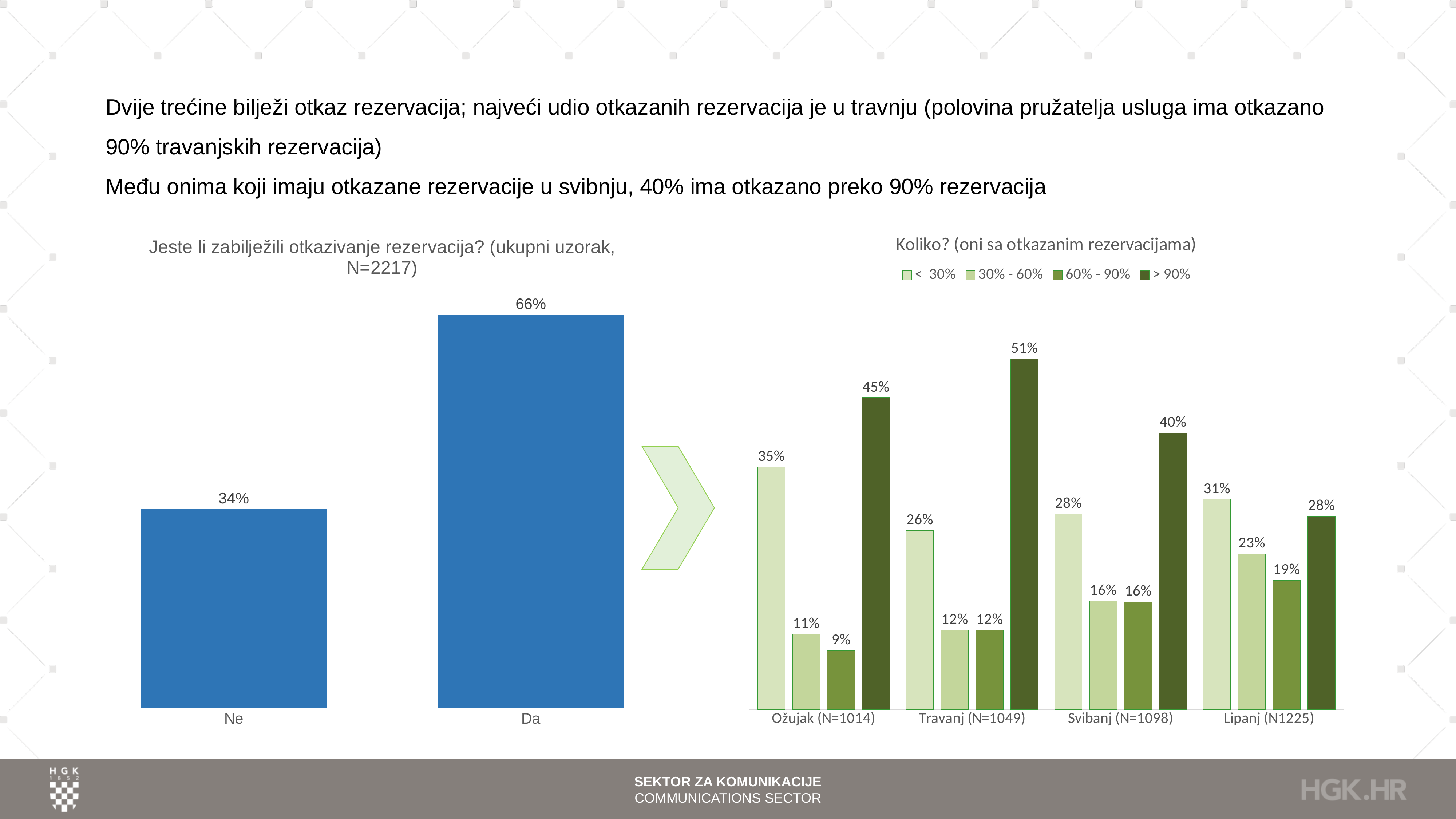
In the right chart (Koliko?), what is the value of the "< 30%" series for Ožujak (N=1014)? 35% In the right chart (Koliko?), what is the value of the "> 90%" series for Travanj (N=1049)? 51% In the left chart (Jeste li zabilježili otkazivanje rezervacija?), how many categories are shown? 2 In the right chart (Koliko?), how many series does the legend list? 4 In the right chart (Koliko?), which month has the lowest value for the "60% - 90%" series? Ožujak (N=1014) In the left chart (Jeste li zabilježili otkazivanje rezervacija?), what is the difference between the "Da" and "Ne" values? 32% In the left chart (Jeste li zabilježili otkazivanje rezervacija?), what is the value for "Ne"? 34% In the left chart (Jeste li zabilježili otkazivanje rezervacija?), what is the value for "Da"? 66% In the right chart (Koliko?), which month has the highest value for the "> 90%" series? Travanj (N=1049) What type of chart is the left chart (Jeste li zabilježili otkazivanje rezervacija?)? Bar chart In the right chart (Koliko?), which is larger for Svibanj (N=1098): the "< 30%" value or the "> 90%" value? > 90% In the right chart (Koliko?), what is the difference between the "< 30%" and "30% - 60%" values for Lipanj (N1225)? 8%